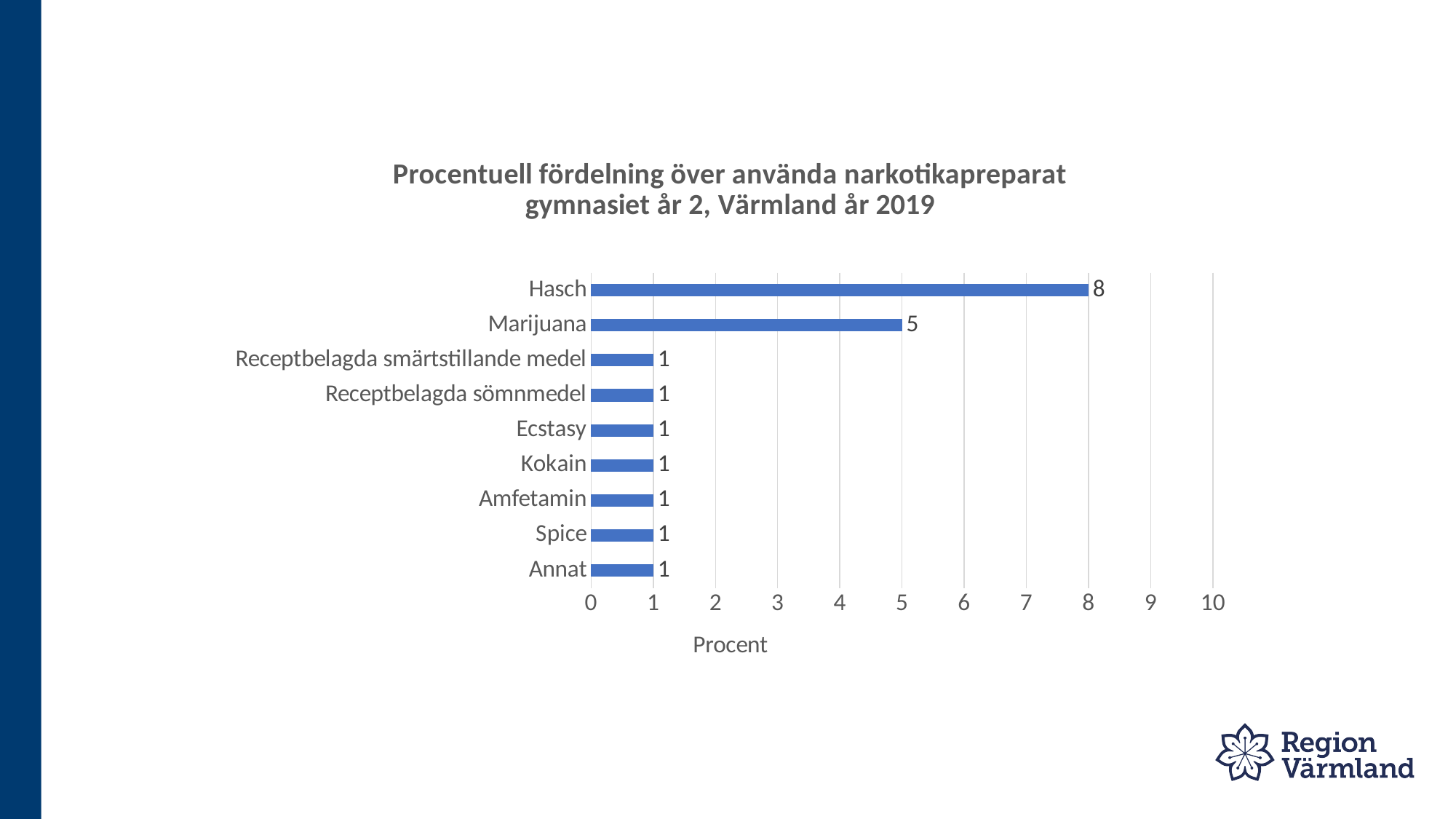
Is the value for Hasch greater or less than 7? greater Which category has the highest value? Hasch What is the value for Hasch? 8 What kind of chart is shown on the slide? Bar chart What is the value for Marijuana? 5 What is the title of the chart? Procentuell fördelning över använda narkotikapreparat gymnasiet år 2, Värmland år 2019 Which is larger, the value for Marijuana or the value for Ecstasy? Marijuana What is the value for Kokain? 1 How many categories are shown in the chart? 9 What is the label of the horizontal axis? Procent How many categories have a value of 1? 7 What is the difference between the values for Hasch and Marijuana? 3